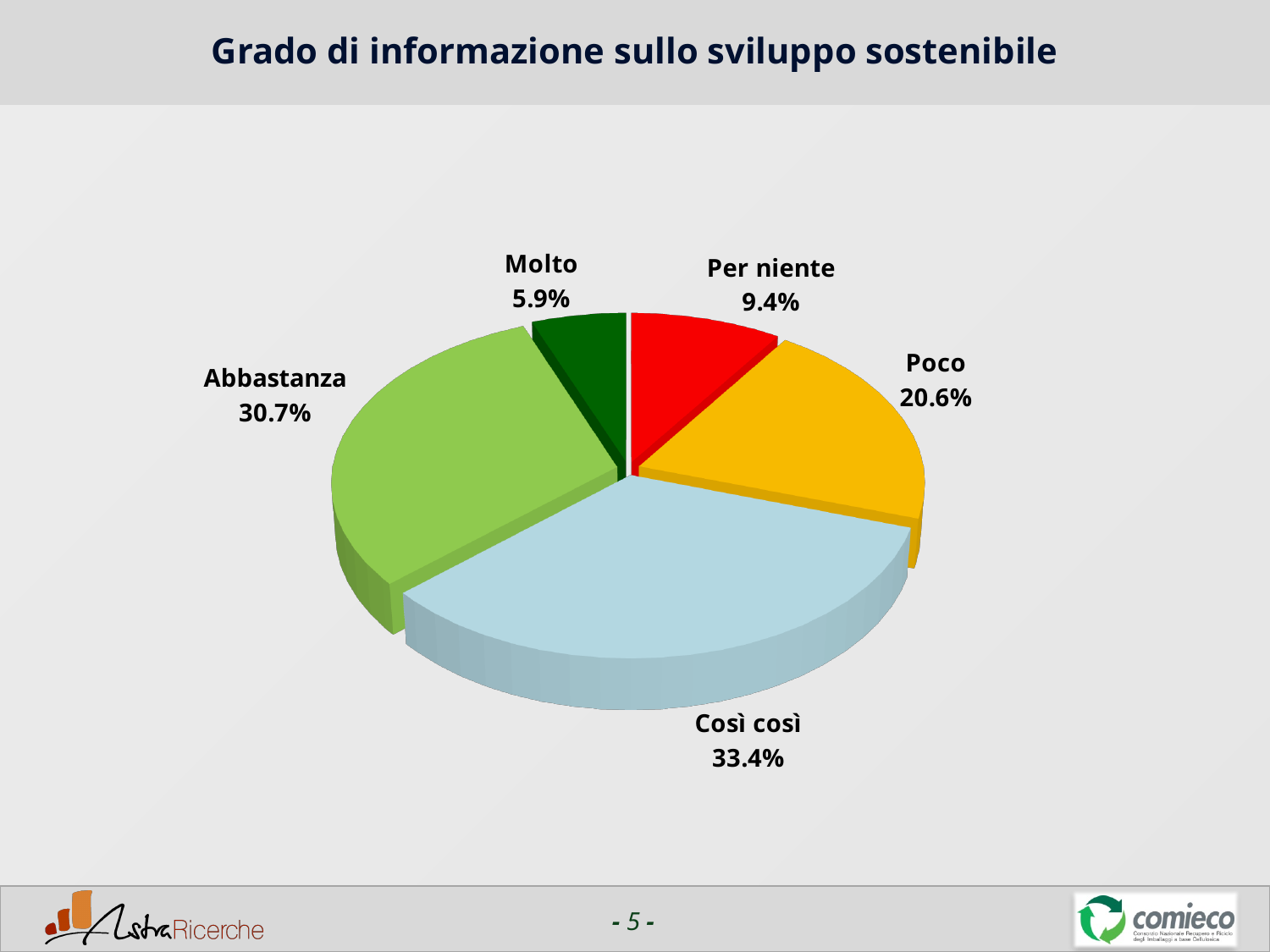
What is the value for "Poco"? 20.6% What type of chart is shown on the slide? pie chart What is the value for "Abbastanza"? 30.7% Which category has the largest share of the pie? Così così How many slices does the pie chart have? 5 Which category has the smallest share of the pie? Molto What is the value for "Per niente"? 9.4% What is the difference between the values for "Così così" and "Abbastanza"? 2.7% What is the title of the chart? Grado di informazione sullo sviluppo sostenibile Which is larger, the value for "Poco" or the value for "Per niente"? Poco What is the value for "Molto"? 5.9% What is the value for "Così così"? 33.4%